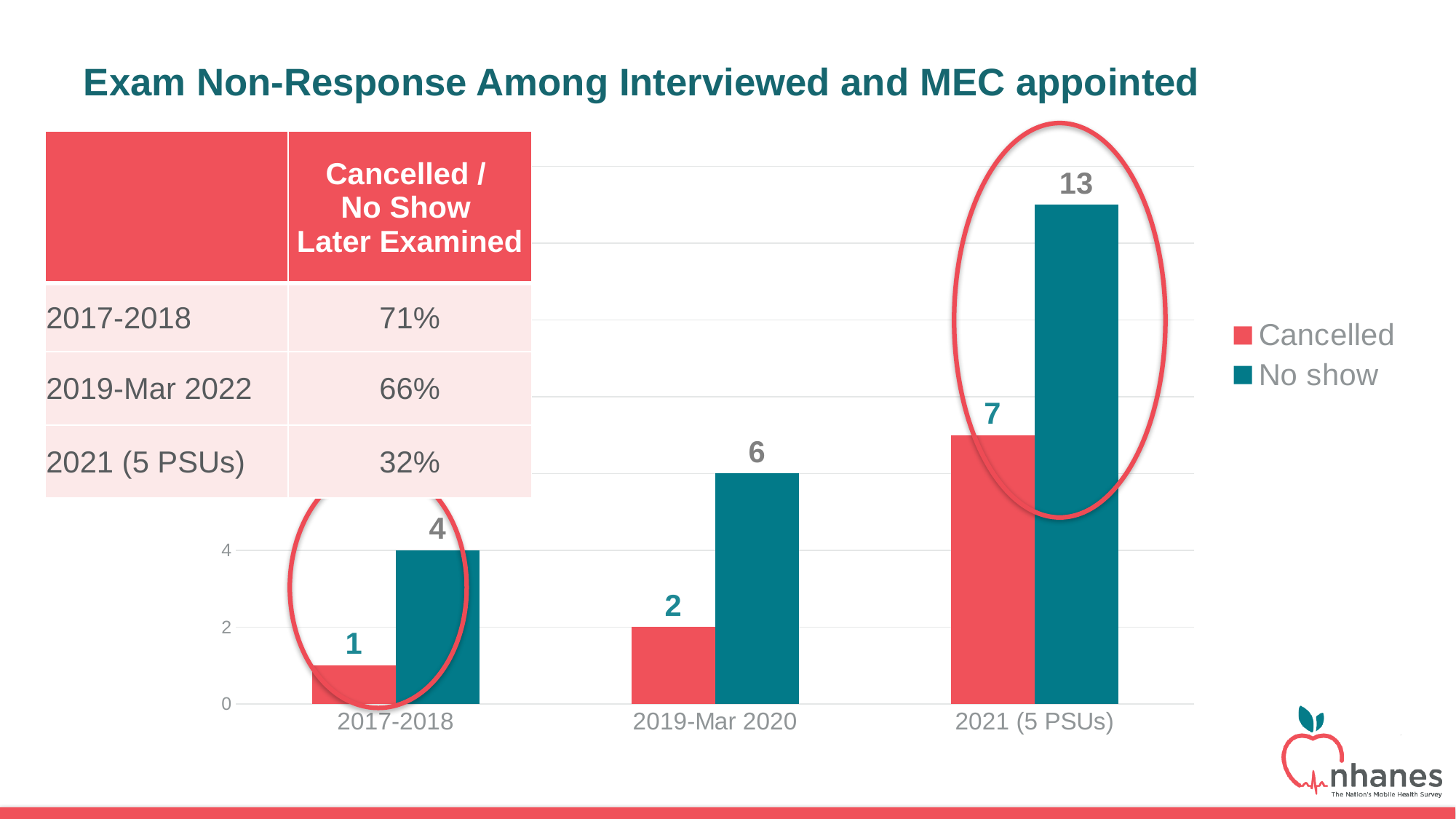
Which category has the highest No show value? 2021 (5 PSUs) How many series does the legend list? 2 What kind of chart is shown on the slide? Bar chart Do the No show values rise or fall from 2017-2018 to 2021 (5 PSUs)? Rise What is the difference between the No show and Cancelled values for 2021 (5 PSUs)? 6 Which is larger for 2019-Mar 2020, Cancelled or No show? No show Which category has the lowest Cancelled value? 2017-2018 What is the No show value for 2021 (5 PSUs)? 13 What is the Cancelled value for 2017-2018? 1 What colour represents the Cancelled series in the legend? Red What is the Cancelled value for 2019-Mar 2020? 2 How many categories are shown on the x axis? 3